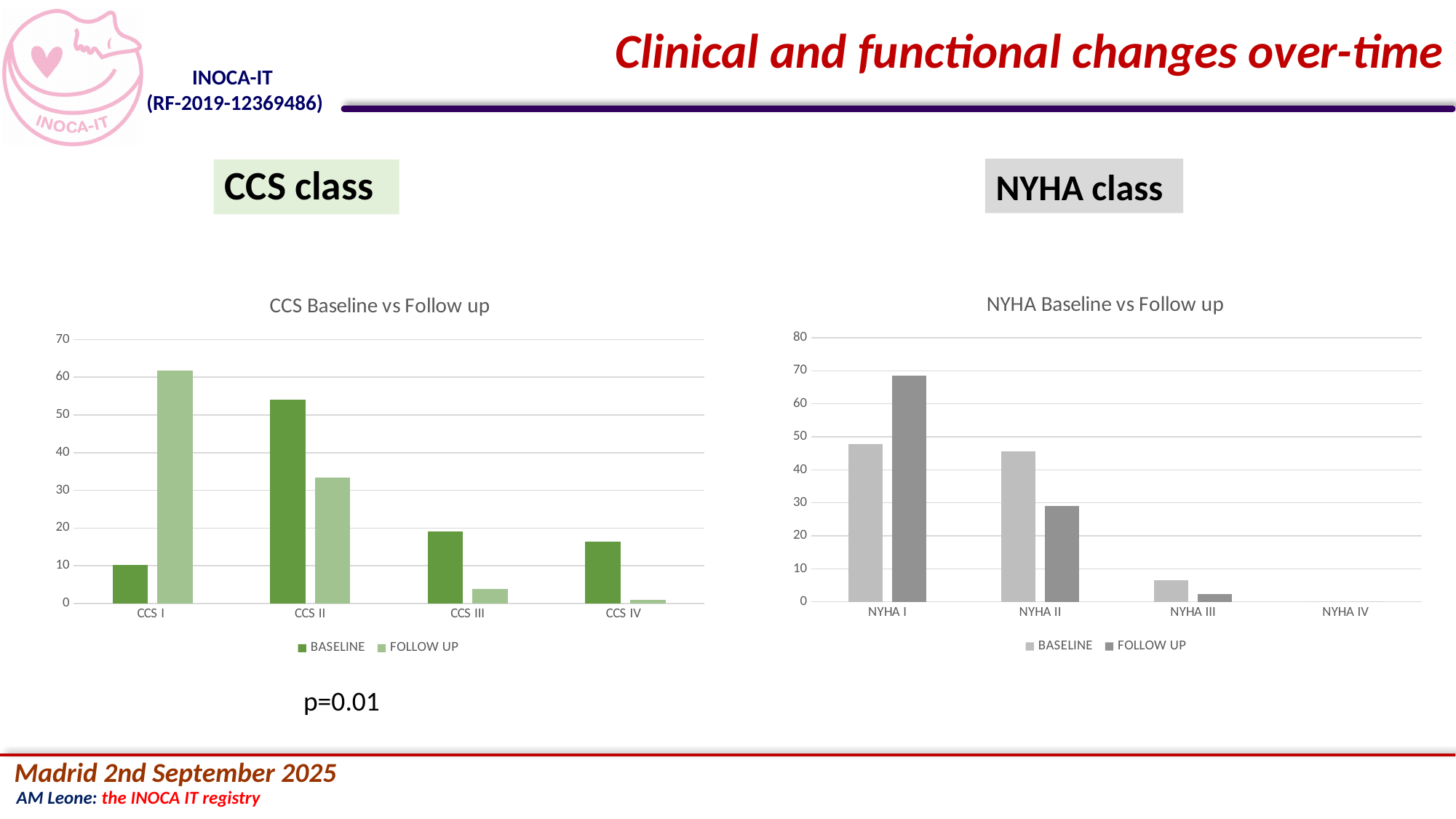
In the NYHA Baseline vs Follow up chart, which is larger for NYHA III: BASELINE or FOLLOW UP? BASELINE How many series does the legend of the CCS Baseline vs Follow up chart list? 2 In the CCS Baseline vs Follow up chart, which category has the highest FOLLOW UP value? CCS I What are the two legend entries of the NYHA Baseline vs Follow up chart? BASELINE and FOLLOW UP In the NYHA Baseline vs Follow up chart, which category has the highest FOLLOW UP value? NYHA I In the CCS Baseline vs Follow up chart, which is larger for CCS II: BASELINE or FOLLOW UP? BASELINE How many categories are shown on the x axis of the CCS Baseline vs Follow up chart? 4 In the CCS Baseline vs Follow up chart, is the FOLLOW UP value for CCS I greater or less than 60? greater In the NYHA Baseline vs Follow up chart, is the FOLLOW UP value for NYHA I greater or less than 60? greater In the CCS Baseline vs Follow up chart, which category has the highest BASELINE value? CCS II How many categories are shown on the x axis of the NYHA Baseline vs Follow up chart? 4 What kind of chart is the CCS Baseline vs Follow up chart? bar chart